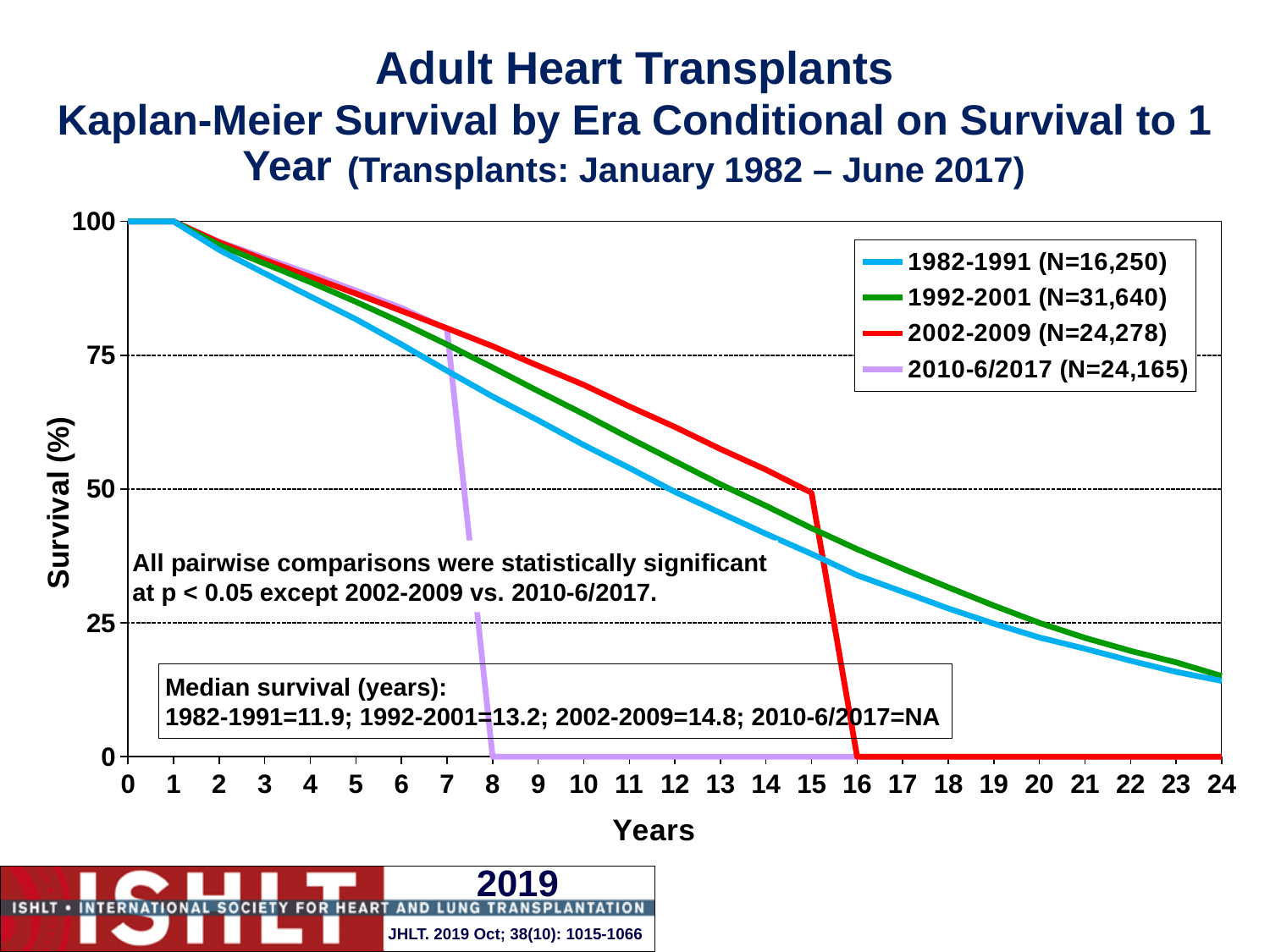
Do the survival curves rise or fall as years increase? fall At year 10, which era has higher survival, 2002-2009 or 1982-1991? 2002-2009 What is the N for the 1992-2001 era shown in the legend? 31,640 At year 10, is survival for the 2002-2009 era greater or less than 50%? greater What kind of chart is shown on the slide? line chart What is the N for the 2010-6/2017 era shown in the legend? 24,165 What is the median survival in years for the 2002-2009 era? 14.8 What is the difference in median survival between the 2002-2009 and 1982-1991 eras? 2.9 years Which era has the highest reported median survival? 2002-2009 Which era has the largest N in the legend? 1992-2001 How many series does the legend list? 4 What is the median survival in years for the 1982-1991 era? 11.9